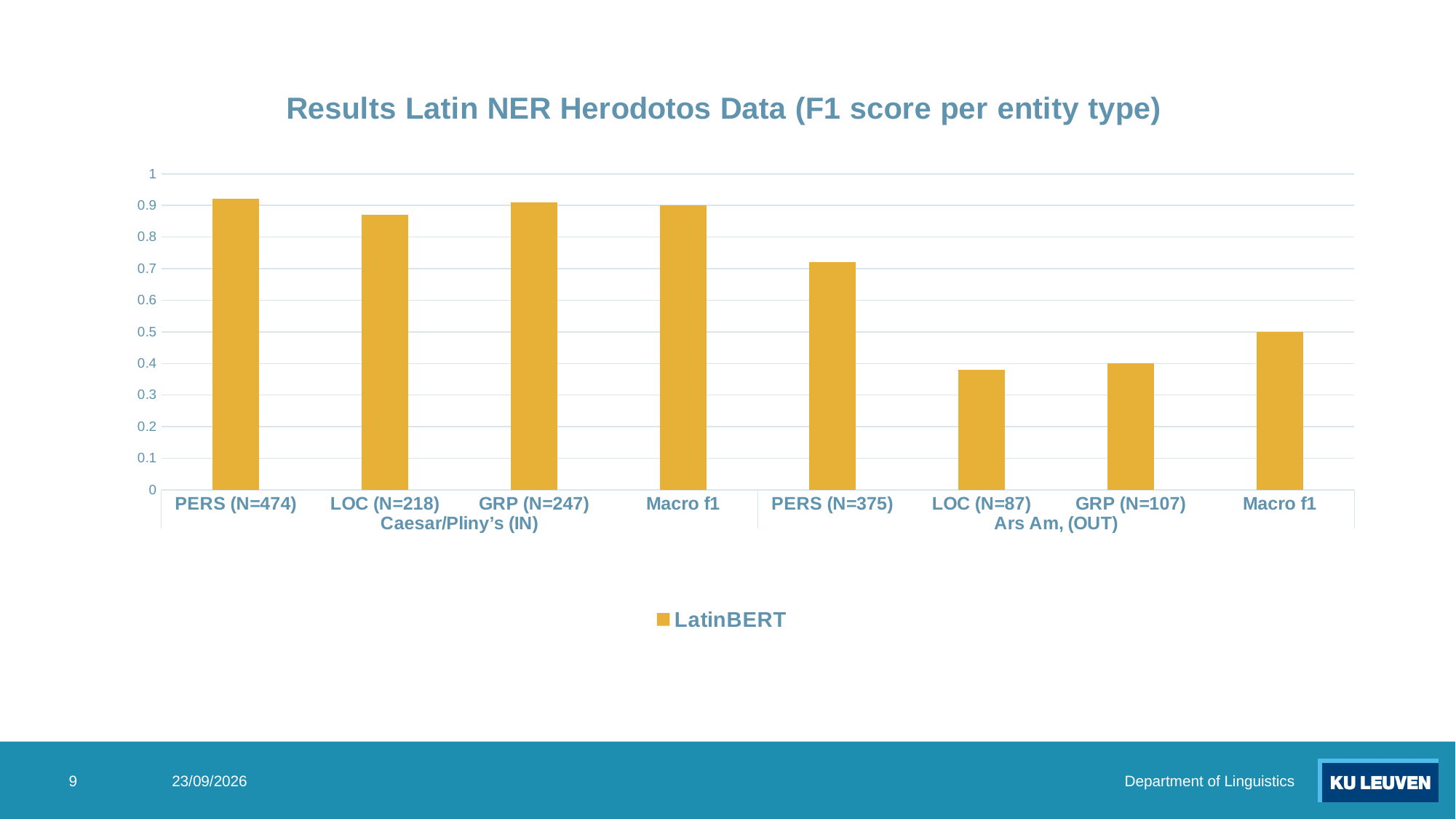
What is the Macro f1 value for the Ars Am, (OUT) group? 0.5 Is the value for LOC (N=218) greater or less than 0.9? less Which is larger, the value for PERS (N=474) or the value for PERS (N=375)? PERS (N=474) Is the value for PERS (N=474) greater or less than 0.9? greater Is the value for LOC (N=87) greater or less than 0.4? less What is the title of the chart? Results Latin NER Herodotos Data (F1 score per entity type) Which is larger, the value for LOC (N=218) or the value for LOC (N=87)? LOC (N=218) How many series does the legend list? 1 What kind of chart is shown on the slide? bar chart What is the name of the series shown in the legend? LatinBERT How many bars are plotted in the chart? 8